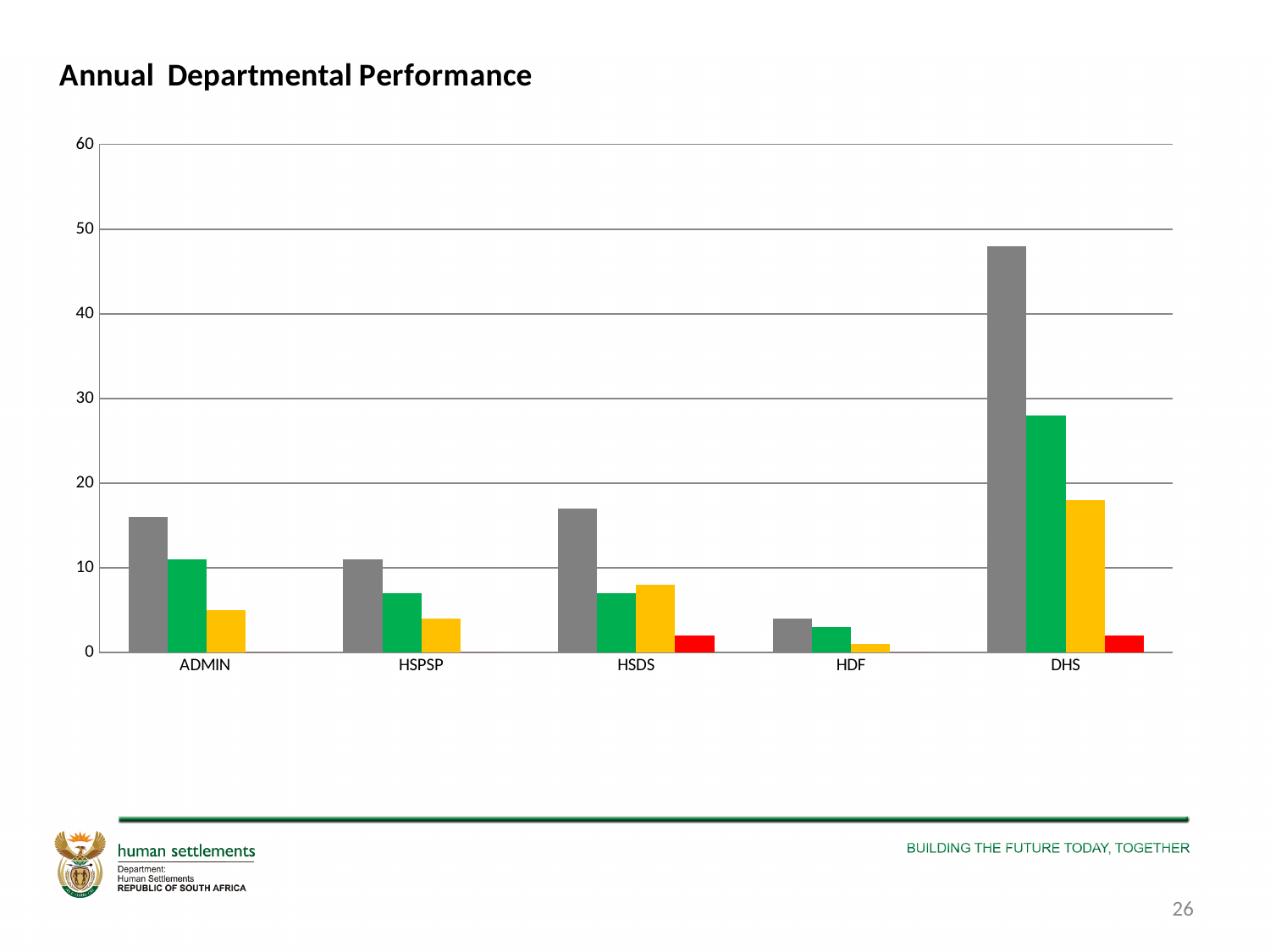
How many categories are shown on the x axis? 5 Is the value of the green bar for DHS greater or less than 20? greater Is the value of the grey bar for DHS greater or less than 40? greater Which category has the tallest yellow bar? DHS Is the value of the grey bar for HSDS greater or less than 10? greater Which is larger, the grey bar for ADMIN or the grey bar for HSPSP? ADMIN What kind of chart is shown on the slide? bar chart What is the title of the chart? Annual Departmental Performance Which category has the shortest grey bar? HDF Which category has the tallest grey bar? DHS